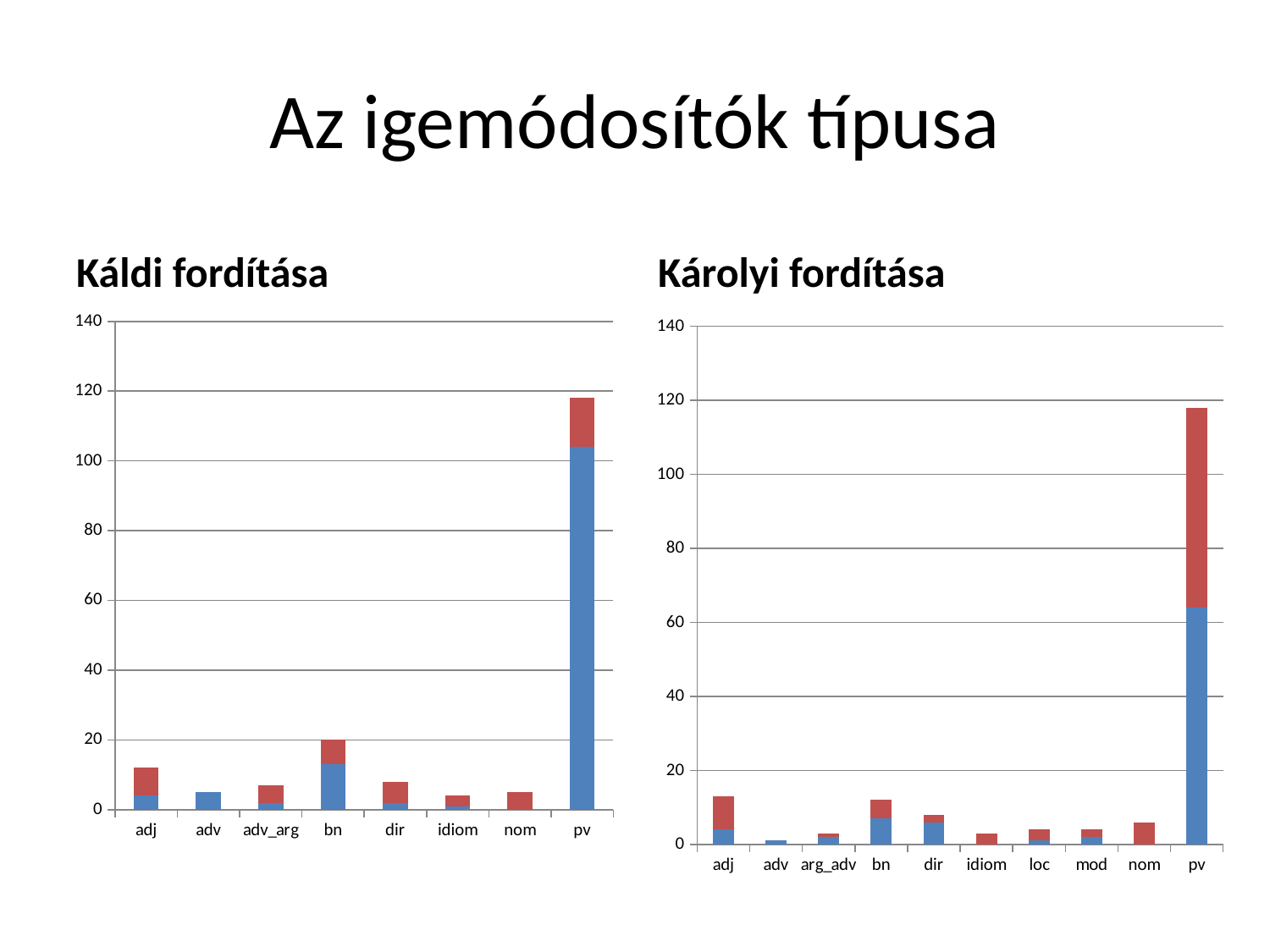
In the 'Károlyi fordítása' chart, which category has the highest total? pv In the 'Káldi fordítása' chart, is the total for pv greater or less than 100? greater How many categories are shown on the x axis of the 'Káldi fordítása' chart? 8 In the 'Káldi fordítása' chart, is the total for bn greater or less than 40? less In the 'Káldi fordítása' chart, which category has the highest total? pv What kind of chart is the 'Káldi fordítása' chart? bar chart How many categories are shown on the x axis of the 'Károlyi fordítása' chart? 10 What is the title of the chart on the right side of the slide? Károlyi fordítása In the 'Károlyi fordítása' chart, which category has the lowest total? adv In the 'Károlyi fordítása' chart, is the total for adj greater or less than 20? less In the 'Káldi fordítása' chart, which has the larger total, bn or adj? bn